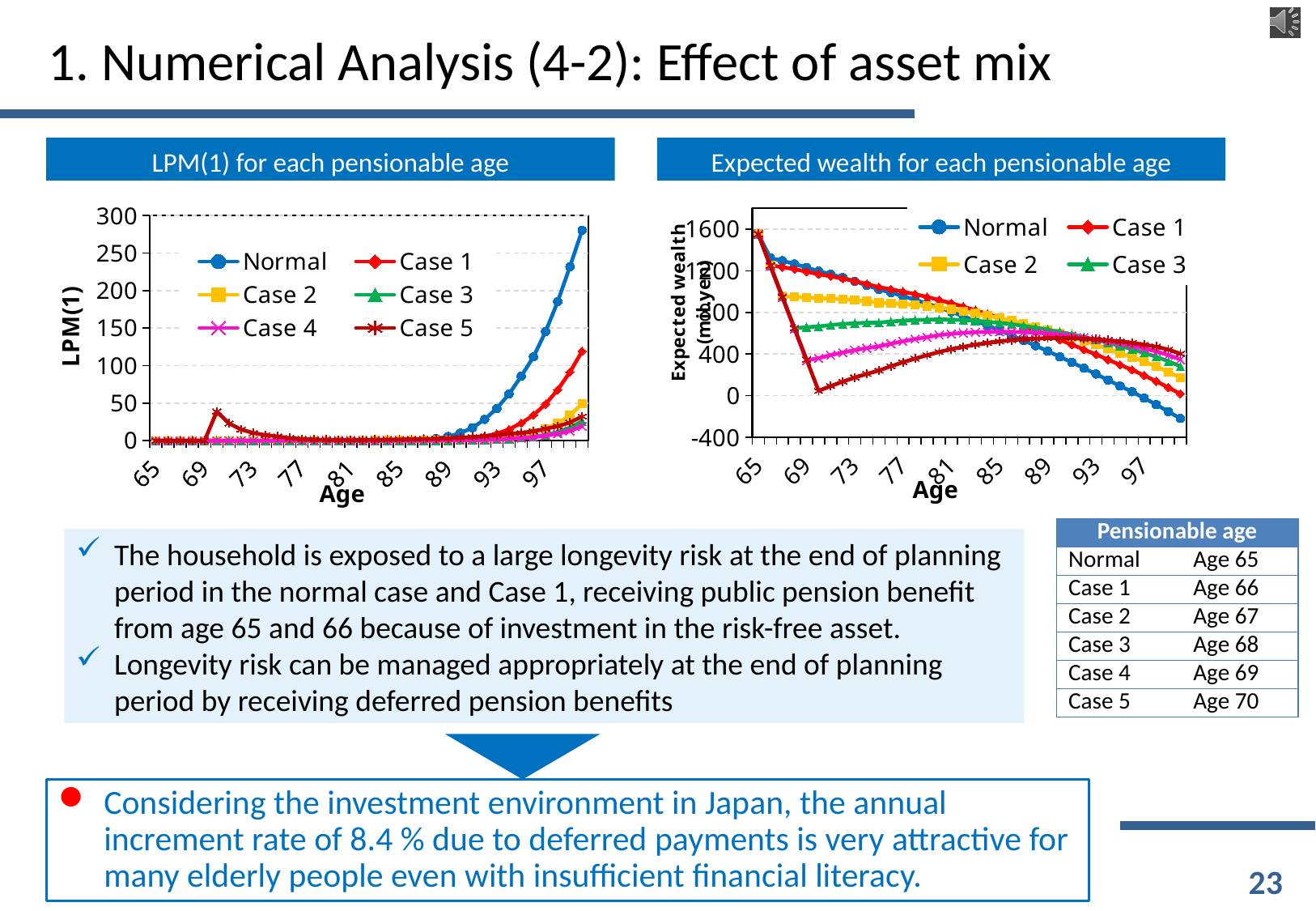
What kind of chart is the 'LPM(1) for each pensionable age' chart? line chart In the 'Expected wealth for each pensionable age' chart, which series has the lowest value at the right end of the age axis? Normal In the 'Expected wealth for each pensionable age' chart, is the value of the Normal series at the last age greater or less than 0? less What is the label of the x axis on the 'Expected wealth for each pensionable age' chart? Age In the 'LPM(1) for each pensionable age' chart, is the value of Case 1 at the last age greater or less than 100? greater In the 'Expected wealth for each pensionable age' chart, does the Normal series rise or fall as age increases? fall How many series does the legend of the 'LPM(1) for each pensionable age' chart list? 6 In the 'LPM(1) for each pensionable age' chart, which series reaches the highest value at the right end of the age axis? Normal In the 'LPM(1) for each pensionable age' chart, is the peak of Case 5 around age 70 greater or less than 50? less In the 'LPM(1) for each pensionable age' chart, which series shows a noticeable spike around age 70? Case 5 How many series does the legend of the 'Expected wealth for each pensionable age' chart list? 4